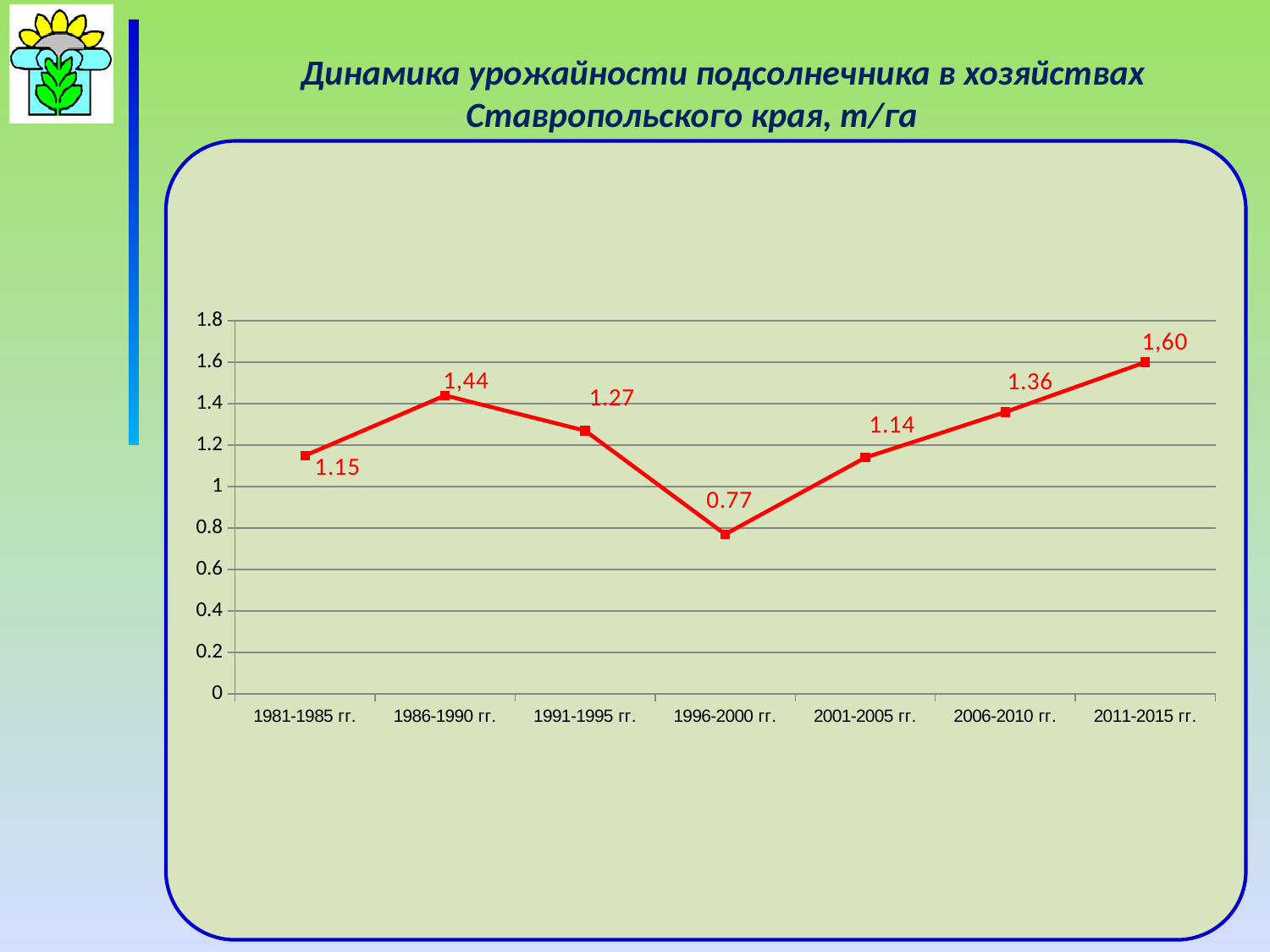
Which period has the highest yield value? 2011-2015 гг. What kind of chart is shown on the slide? line chart Do the values rise or fall from 1996-2000 гг. to 2011-2015 гг.? rise What is the value shown for 2011-2015 гг.? 1,60 What is the value shown for 2006-2010 гг.? 1.36 How many periods are plotted on the x axis? 7 What is the value shown for 1996-2000 гг.? 0.77 Which period has the lowest yield value? 1996-2000 гг. What is the difference between the values for 1986-1990 гг. and 1991-1995 гг.? 0.17 Which is larger, the value for 1981-1985 гг. or the value for 2001-2005 гг.? 1981-1985 гг. What is the sunflower yield value for 1981-1985 гг.? 1.15 Is the value for 1996-2000 гг. greater or less than 1? less